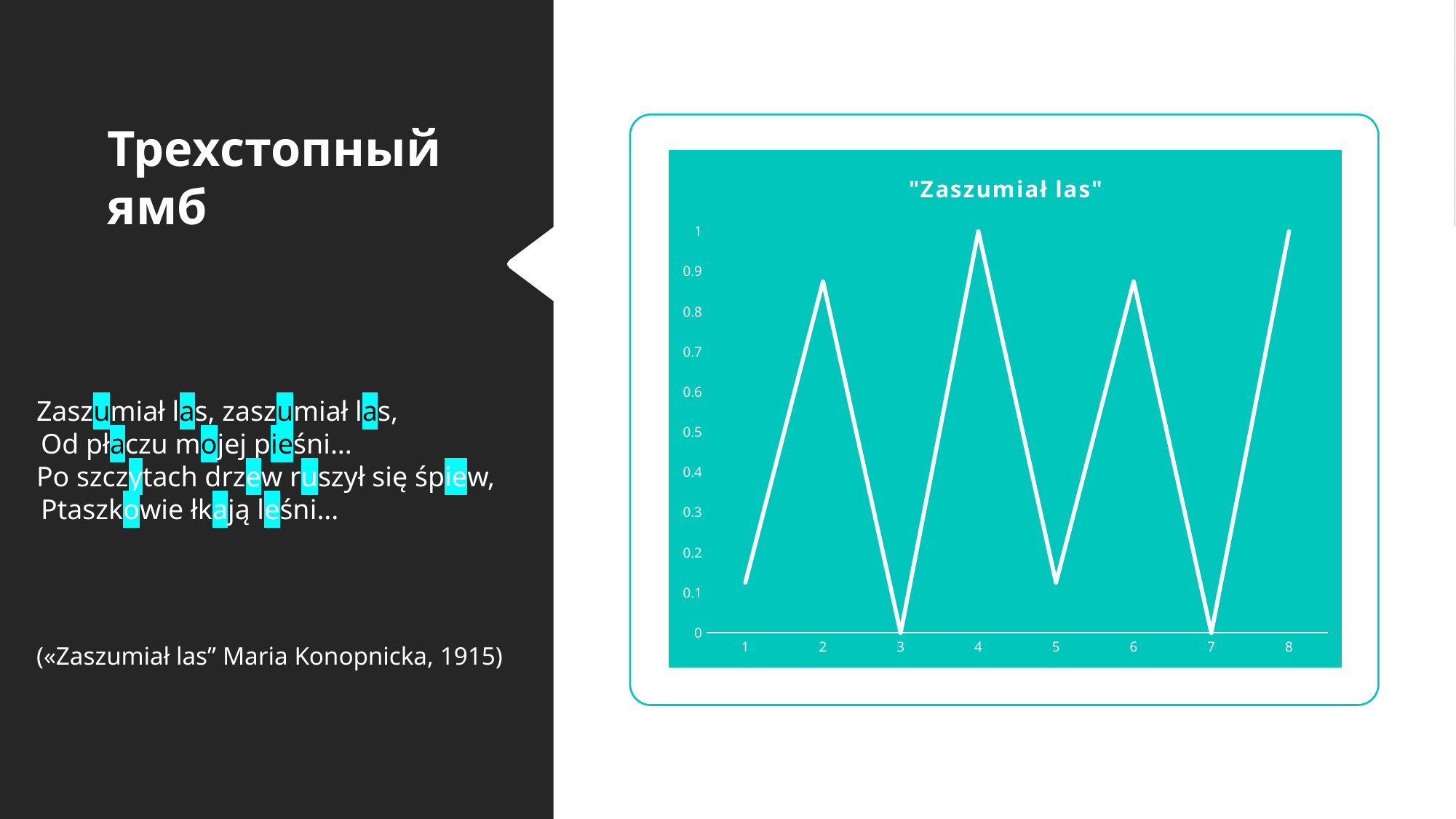
What is the highest value reached on the chart? 1 What is the value at point 4 on the chart? 1 Which is larger, the value at point 6 or the value at point 7? point 6 What is the value at point 3 on the chart? 0 What is the value at point 7 on the chart? 0 Is the value at point 2 greater or less than 0.8? greater What is the value at point 8 on the chart? 1 What is the title of the chart? "Zaszumiał las" What kind of chart is shown on the slide? line chart Is the value at point 5 greater or less than 0.2? less What is the lowest value reached on the chart? 0 How many points are plotted on the chart? 8